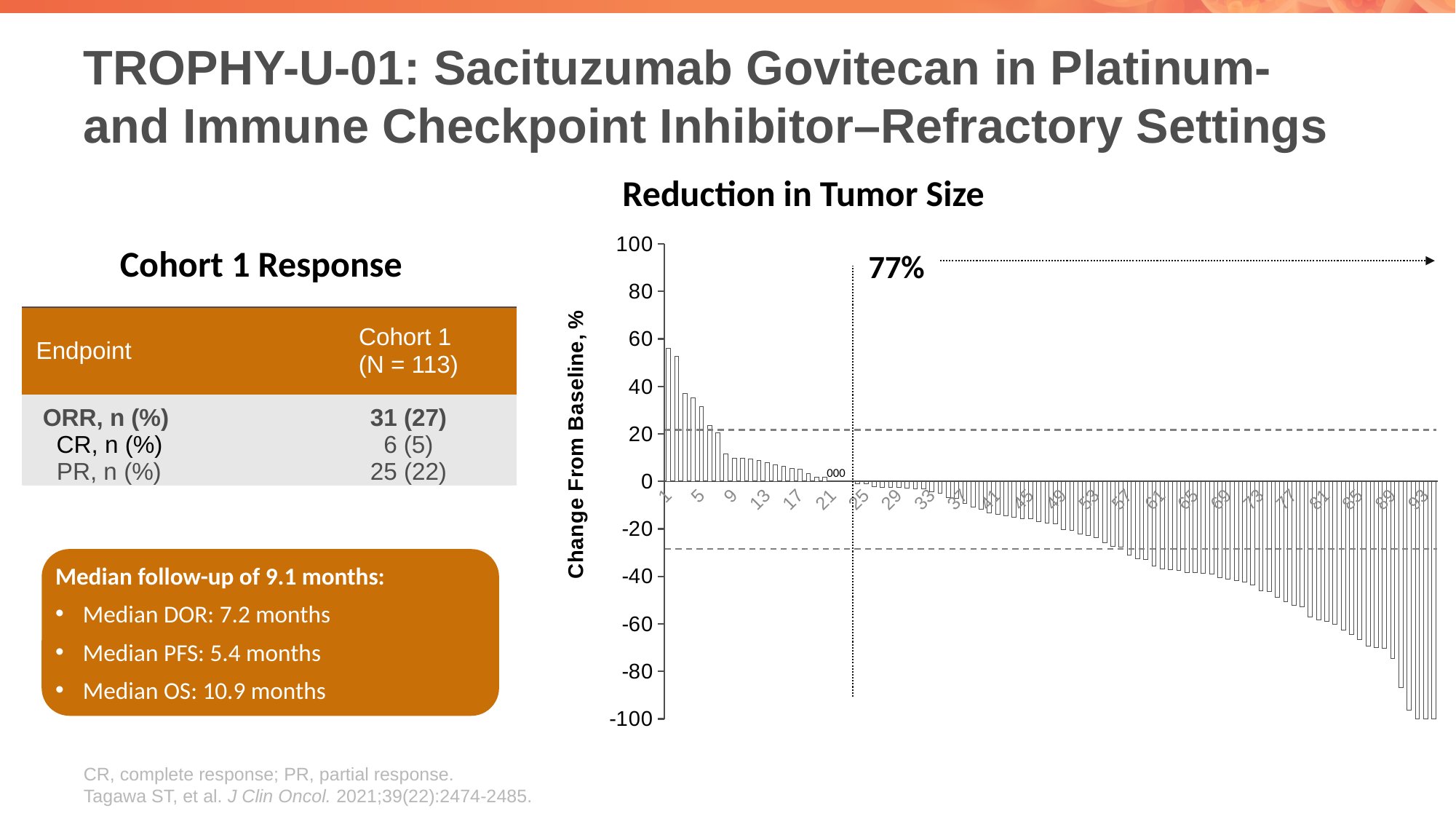
What is the y-axis label of the "Reduction in Tumor Size" chart? Change From Baseline, % In the "Reduction in Tumor Size" chart, is the value for patient 61 greater or less than -20? less In the "Reduction in Tumor Size" chart, is the value for patient 1 greater or less than 40? greater What is the title of the chart on the right side of the slide? Reduction in Tumor Size In the "Reduction in Tumor Size" chart, is the value for patient 93 greater or less than -60? less What kind of chart is the "Reduction in Tumor Size" chart? bar chart In the "Reduction in Tumor Size" chart, which patient number has the highest change from baseline? 1 In the "Reduction in Tumor Size" chart, do the bar values rise or fall moving left to right along the x axis? fall In the "Reduction in Tumor Size" chart, which has the larger change from baseline, patient 1 or patient 5? patient 1